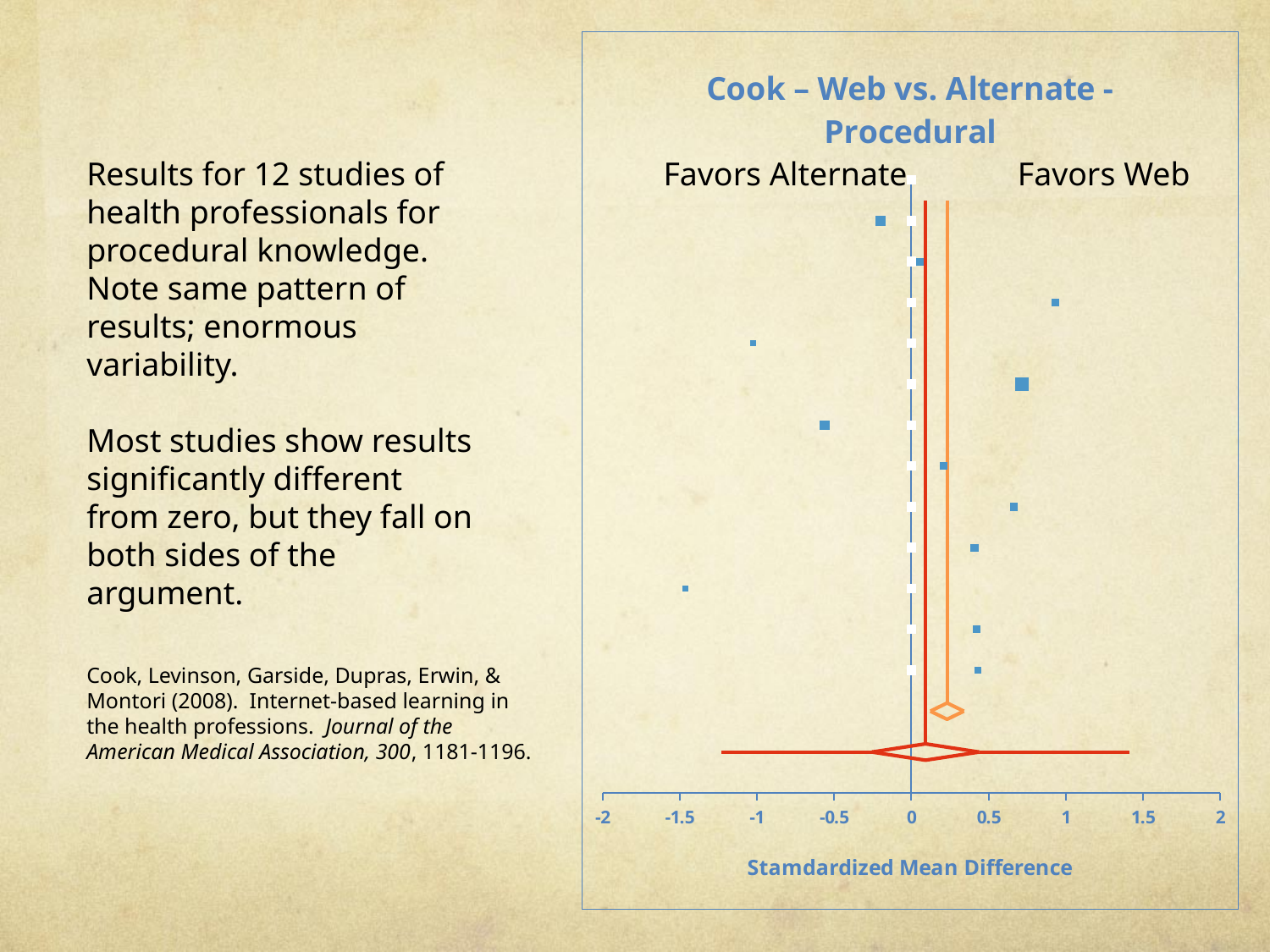
What is the label on the horizontal axis of the chart? Stamdardized Mean Difference Is the highest plotted value on the chart greater or less than 1? less How many plotted points on the chart have a value greater than 1? 0 How many tick labels are shown on the horizontal axis of the chart? 9 What kind of chart is shown on the slide? scatter chart What is the title of the chart? Cook – Web vs. Alternate - Procedural Is the lowest (leftmost) plotted value on the chart greater or less than -1? less Is the highest (rightmost) plotted value on the chart greater or less than 0.5? greater How many study points (blue squares) are plotted on the chart? 12